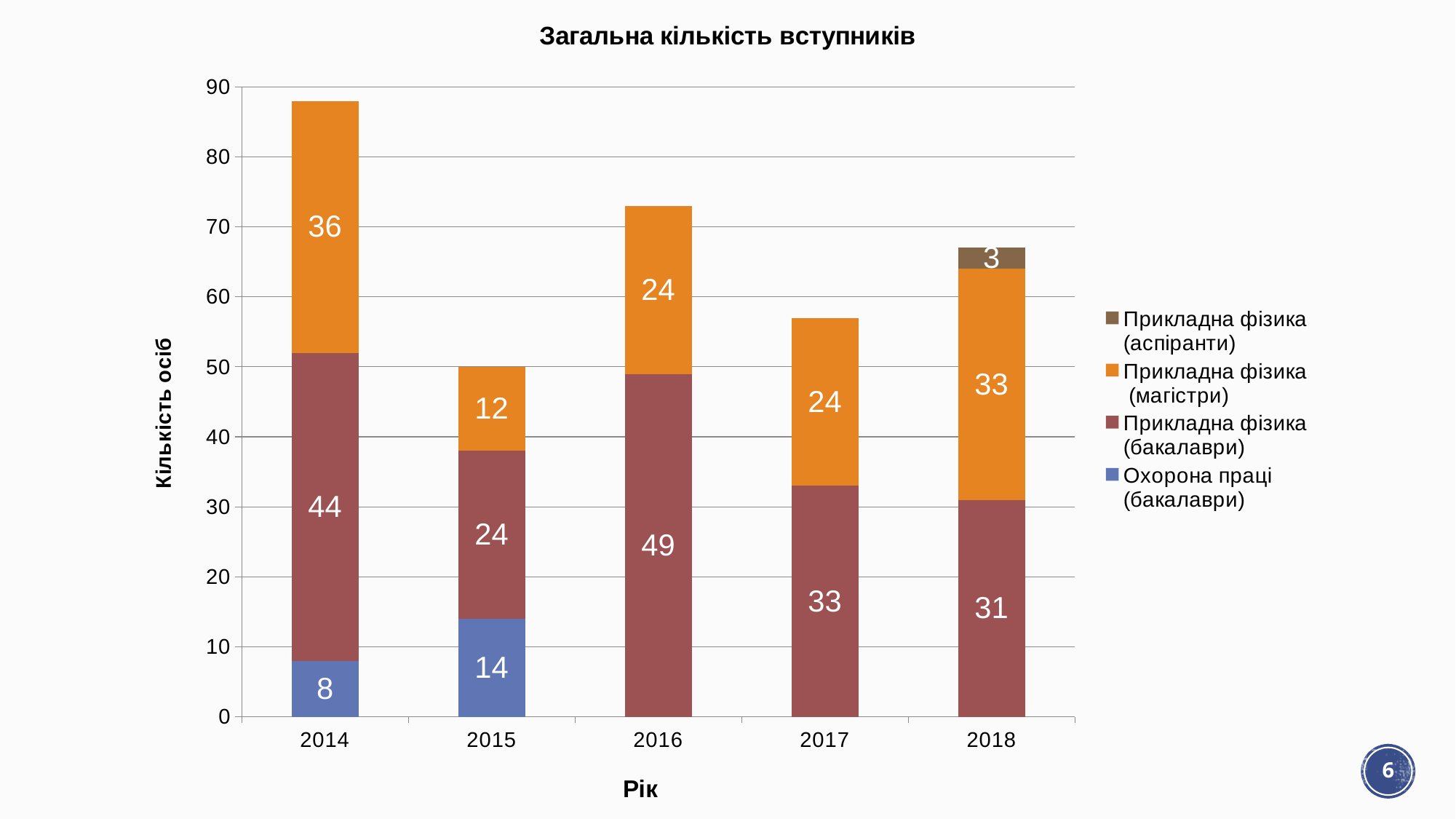
What is the total of the stacked bar for 2018? 67 What is the value for Прикладна фізика (бакалаври) in 2016? 49 Which is larger: Прикладна фізика (магістри) in 2018 or Прикладна фізика (бакалаври) in 2018? Прикладна фізика (магістри) What is the difference between Прикладна фізика (бакалаври) in 2014 and in 2015? 20 Which year has the highest value for Прикладна фізика (магістри)? 2014 What is the title of the chart? Загальна кількість вступників What is the value for Прикладна фізика (аспіранти) in 2018? 3 What kind of chart is shown on the slide? stacked bar chart How many years are shown on the x axis? 5 What is the total of the stacked bar for 2014? 88 What is the value for Охорона праці (бакалаври) in 2015? 14 How many series does the legend list? 4